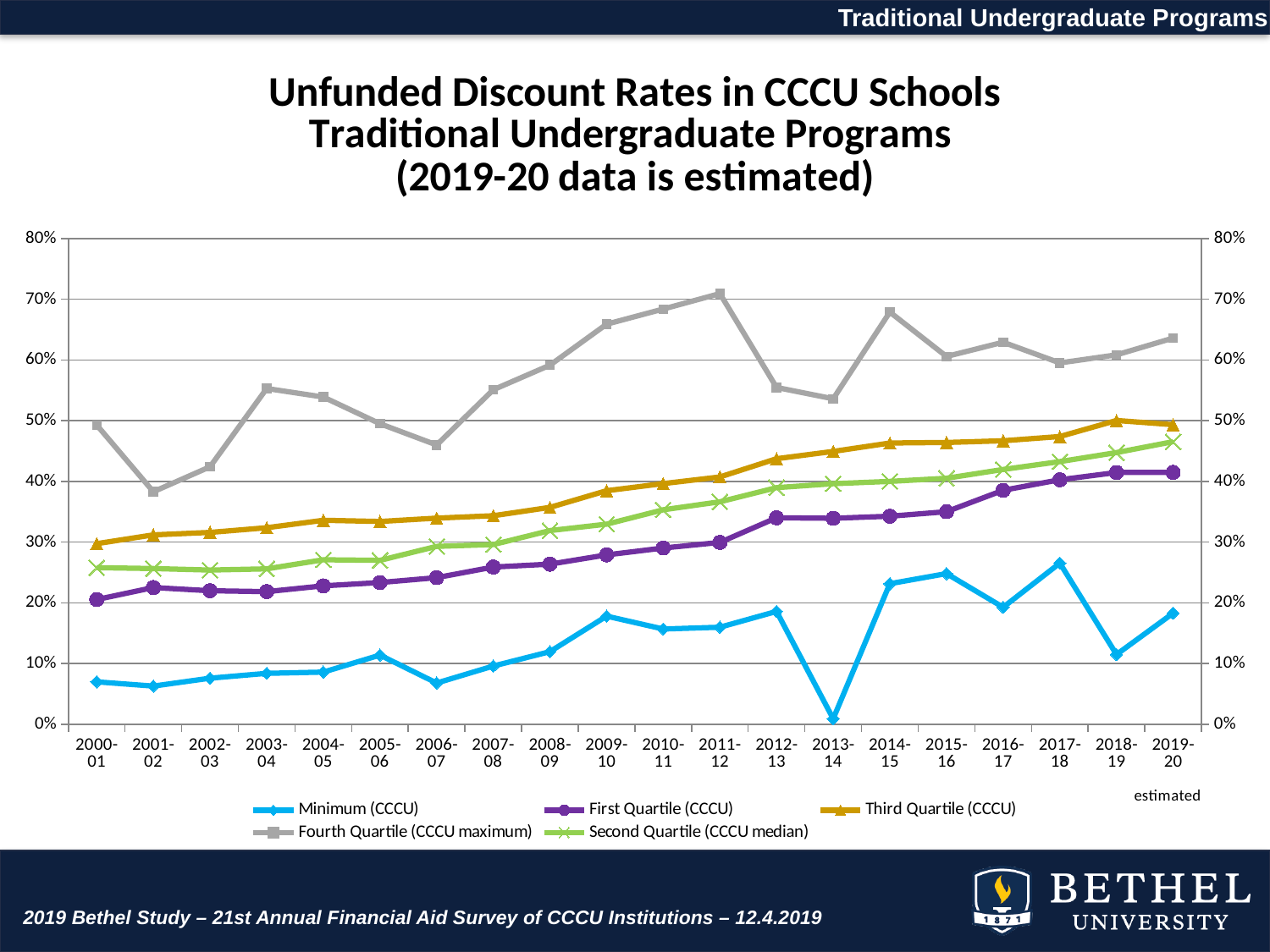
In which year does the Fourth Quartile (CCCU maximum) series reach its highest value? 2011-12 Is the Minimum (CCCU) value for 2013-14 greater or less than 10%? less Is the Fourth Quartile (CCCU maximum) value for 2001-02 greater or less than 40%? less Is the Second Quartile (CCCU median) value for 2019-20 greater or less than 40%? greater How many series does the legend list? 5 How many academic years are plotted along the x axis? 20 What kind of chart is shown on the slide? line chart In which year does the Minimum (CCCU) series reach its lowest value? 2013-14 Which legend entry corresponds to the gray line with square markers? Fourth Quartile (CCCU maximum) In 2019-20, which is higher: the Third Quartile (CCCU) or the Second Quartile (CCCU median)? Third Quartile (CCCU) Does the First Quartile (CCCU) series generally rise or fall from 2000-01 to 2019-20? rise